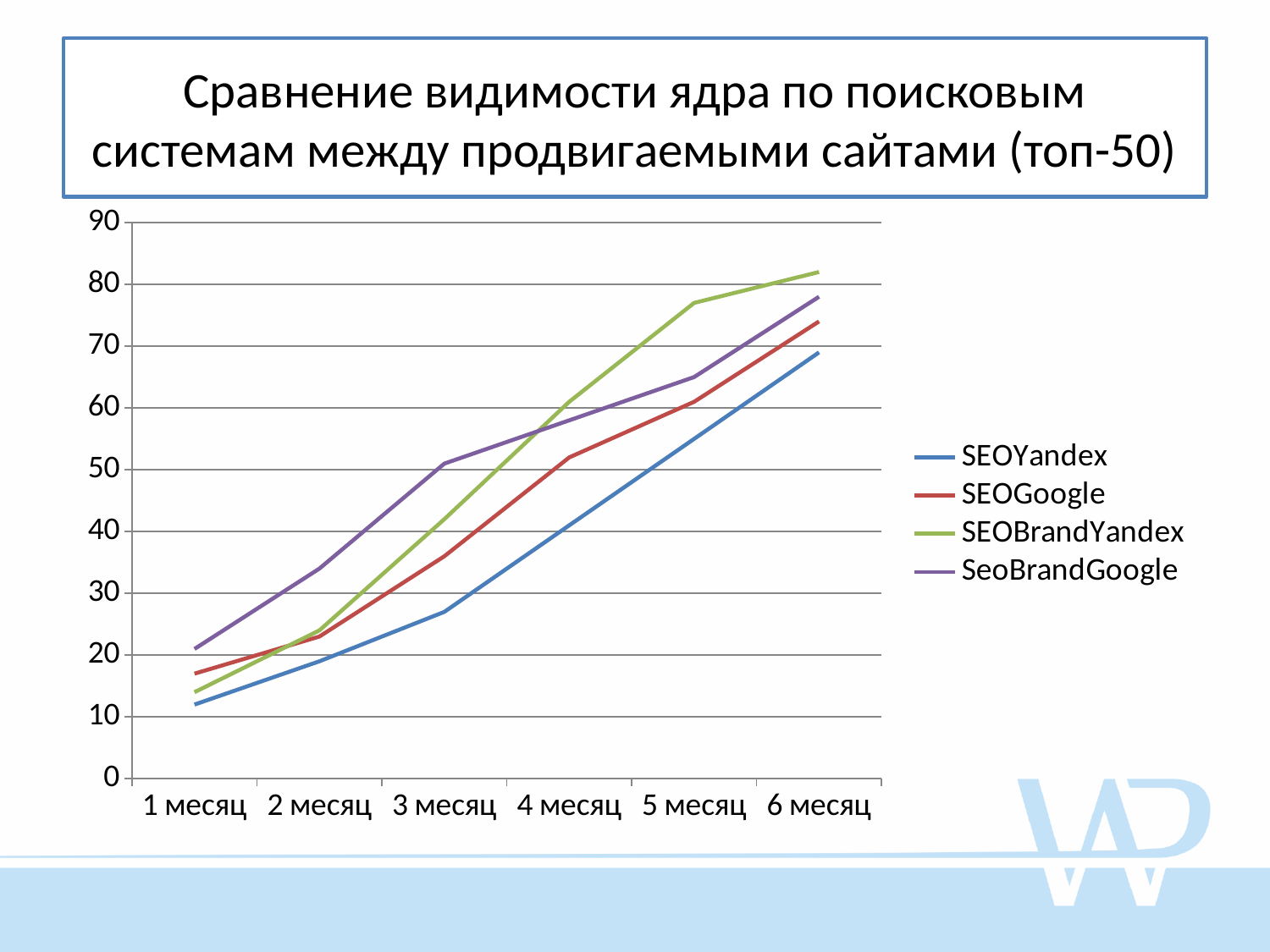
Do the values for SEOYandex rise or fall from 1 месяц to 6 месяц? rise What kind of chart is shown on the slide? line chart How many categories (months) are shown on the x axis? 6 Which series has the highest value at 1 месяц? SeoBrandGoogle How many series does the legend list? 4 Is the value for SEOYandex at 1 месяц greater or less than 20? less Which series has the highest value at 6 месяц? SEOBrandYandex Is the value for SEOBrandYandex at 5 месяц greater or less than 70? greater Which series has the lowest value at 6 месяц? SEOYandex Is the value for SEOGoogle at 3 месяц greater or less than 40? less What colour is the SEOYandex line in the legend? blue At 4 месяц, which is larger: SEOBrandYandex or SEOGoogle? SEOBrandYandex